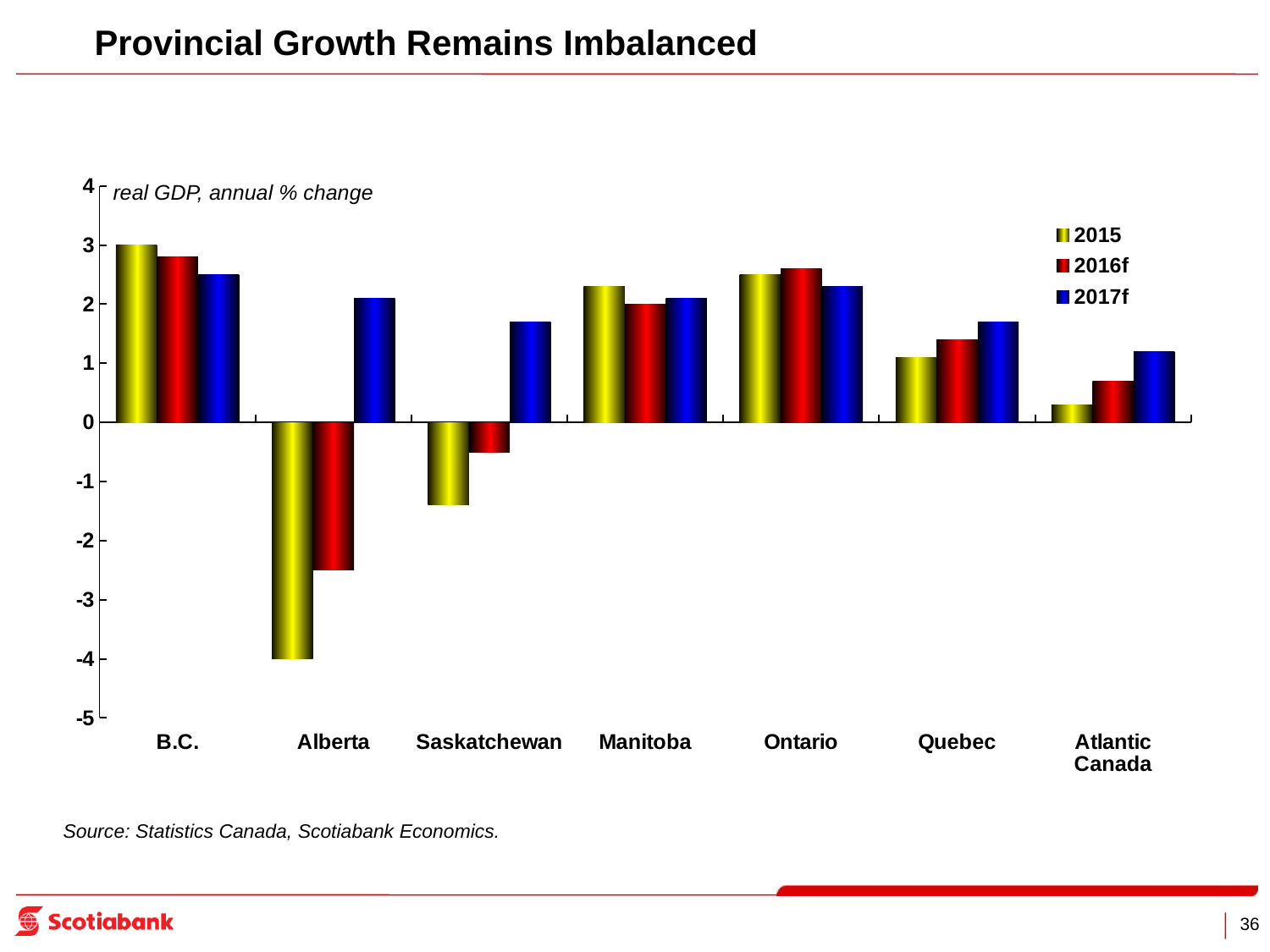
What is the 2015 real GDP growth value for Alberta? -4 How many provinces or regions are shown on the x axis? 7 What kind of chart is shown on the slide? bar chart What is the 2015 real GDP growth value for B.C.? 3 How many series does the legend list? 3 Which is larger, the 2017f value for B.C. or the 2017f value for Atlantic Canada? B.C. Which province has the highest 2015 value? B.C. What does the label inside the chart say the values represent? real GDP, annual % change Is the 2016f value for Alberta greater or less than -2? less Is the 2015 value for Saskatchewan greater or less than -1? less Which province has the lowest 2015 value? Alberta